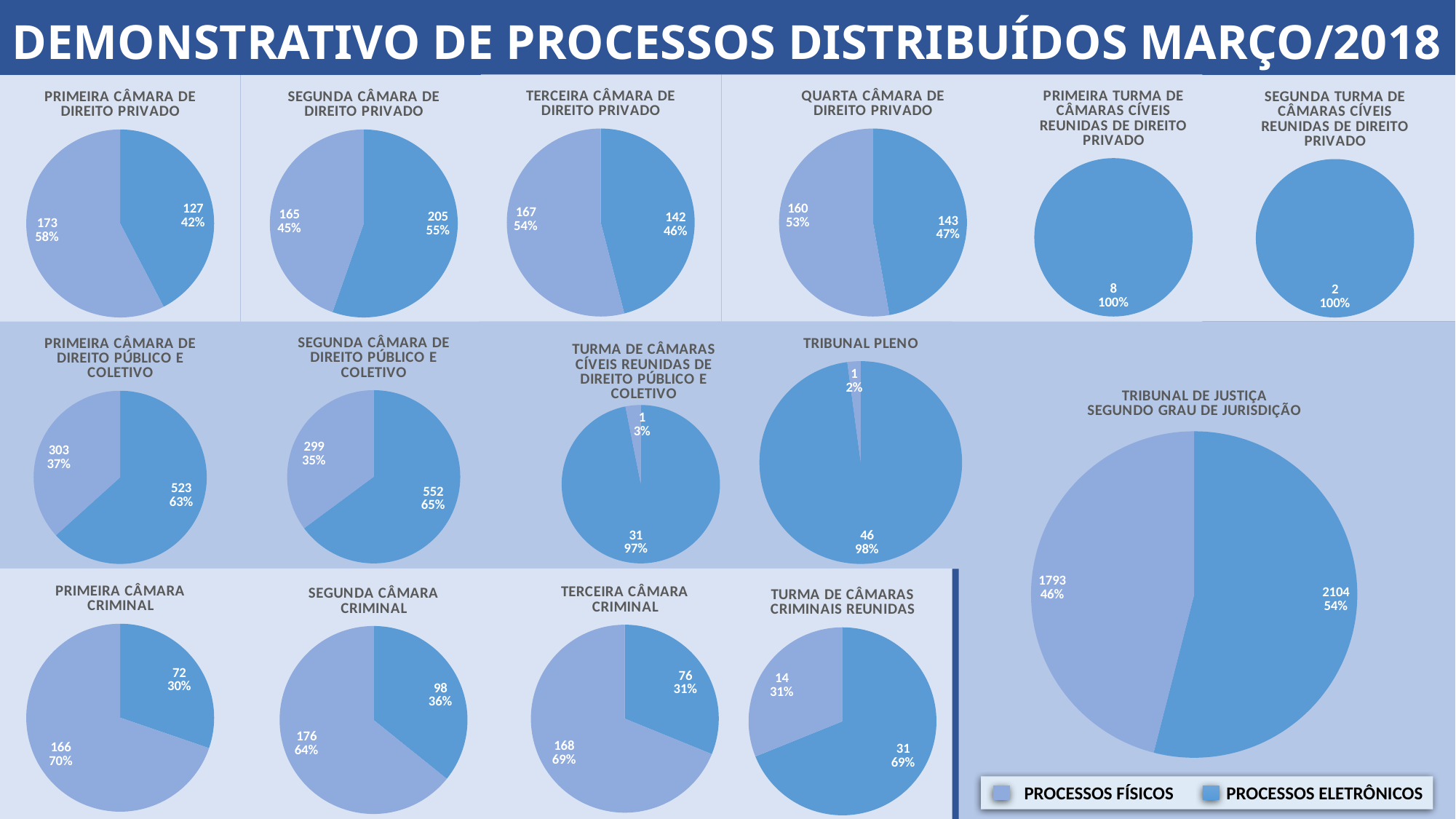
In the 'PRIMEIRA CÂMARA CRIMINAL' chart, what is the total of the two slices? 238 In the 'TURMA DE CÂMARAS CRIMINAIS REUNIDAS' chart, what is the value for PROCESSOS FÍSICOS? 14 In the 'SEGUNDA CÂMARA DE DIREITO PRIVADO' chart, which slice is larger, PROCESSOS FÍSICOS or PROCESSOS ELETRÔNICOS? PROCESSOS ELETRÔNICOS In the 'TRIBUNAL DE JUSTIÇA SEGUNDO GRAU DE JURISDIÇÃO' chart, what share of the pie is PROCESSOS FÍSICOS? 46% What kind of chart is used throughout the slide? Pie chart In the 'TRIBUNAL DE JUSTIÇA SEGUNDO GRAU DE JURISDIÇÃO' chart, what is the value for PROCESSOS ELETRÔNICOS? 2104 In the 'TRIBUNAL PLENO' chart, what percentage is shown for PROCESSOS ELETRÔNICOS? 98% In the 'TERCEIRA CÂMARA CRIMINAL' chart, which slice is smaller, PROCESSOS FÍSICOS or PROCESSOS ELETRÔNICOS? PROCESSOS ELETRÔNICOS In the 'SEGUNDA TURMA DE CÂMARAS CÍVEIS REUNIDAS DE DIREITO PRIVADO' chart, what value is shown? 2 In the 'SEGUNDA CÂMARA DE DIREITO PÚBLICO E COLETIVO' chart, what is the difference between PROCESSOS ELETRÔNICOS and PROCESSOS FÍSICOS? 253 How many series does the legend list? 2 In the 'PRIMEIRA CÂMARA DE DIREITO PRIVADO' chart, what is the value for PROCESSOS FÍSICOS? 173